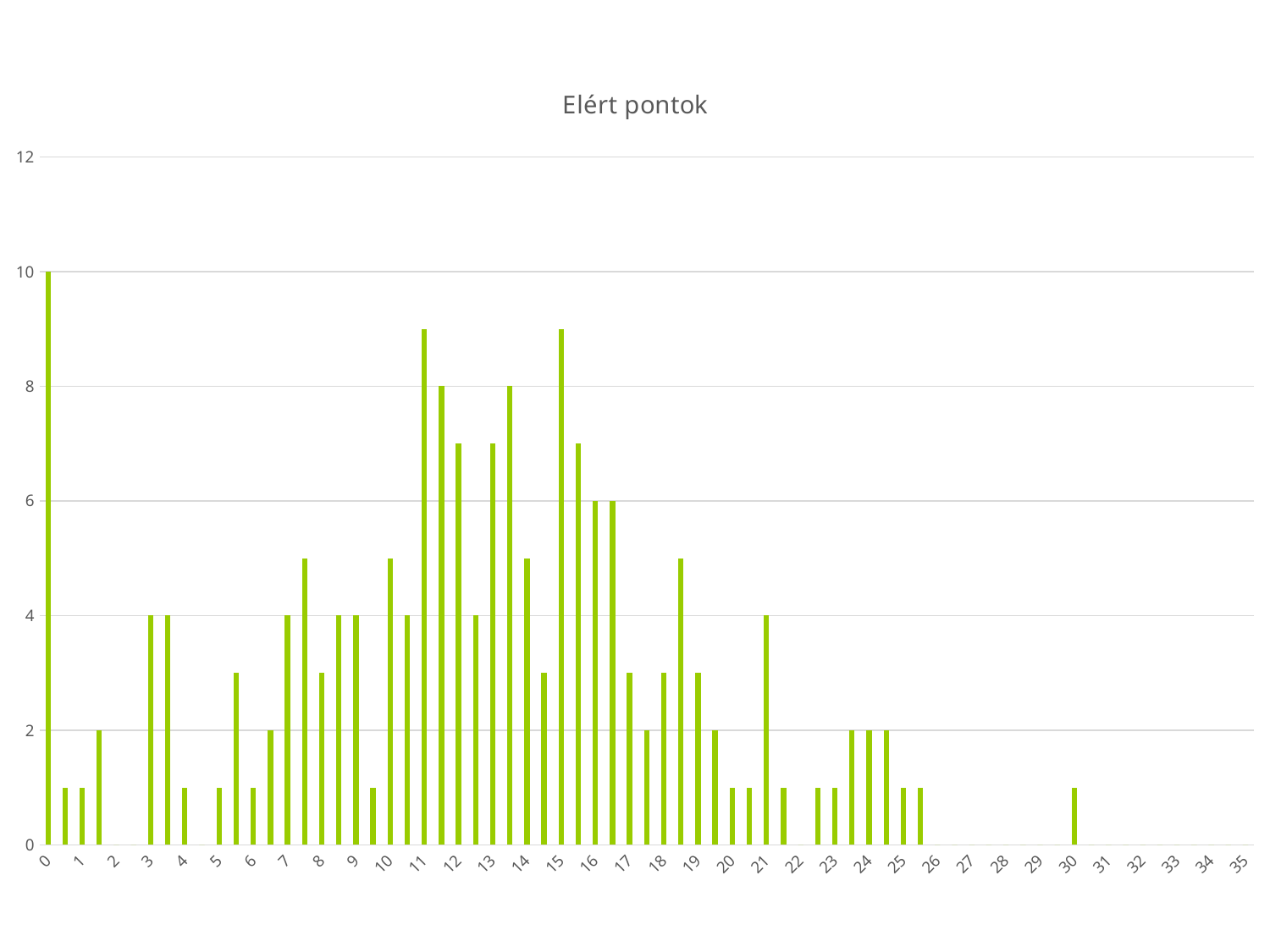
Which category has the tallest bar? 0 What kind of chart is shown on the slide? bar chart What is the value of the bar at category 16? 6 Is the value for category 17 greater or less than 4? less What is the value of the bar at category 24? 2 Is the value for category 30 greater or less than 2? less What is the difference between the bar at category 0 and the bar at category 3? 6 Which is larger, the bar at category 16 or the bar at category 17? 16 What is the value of the bar at category 3? 4 What is the title of the chart? Elért pontok Is the value for category 11 greater or less than 8? greater What is the value of the bar at category 0? 10